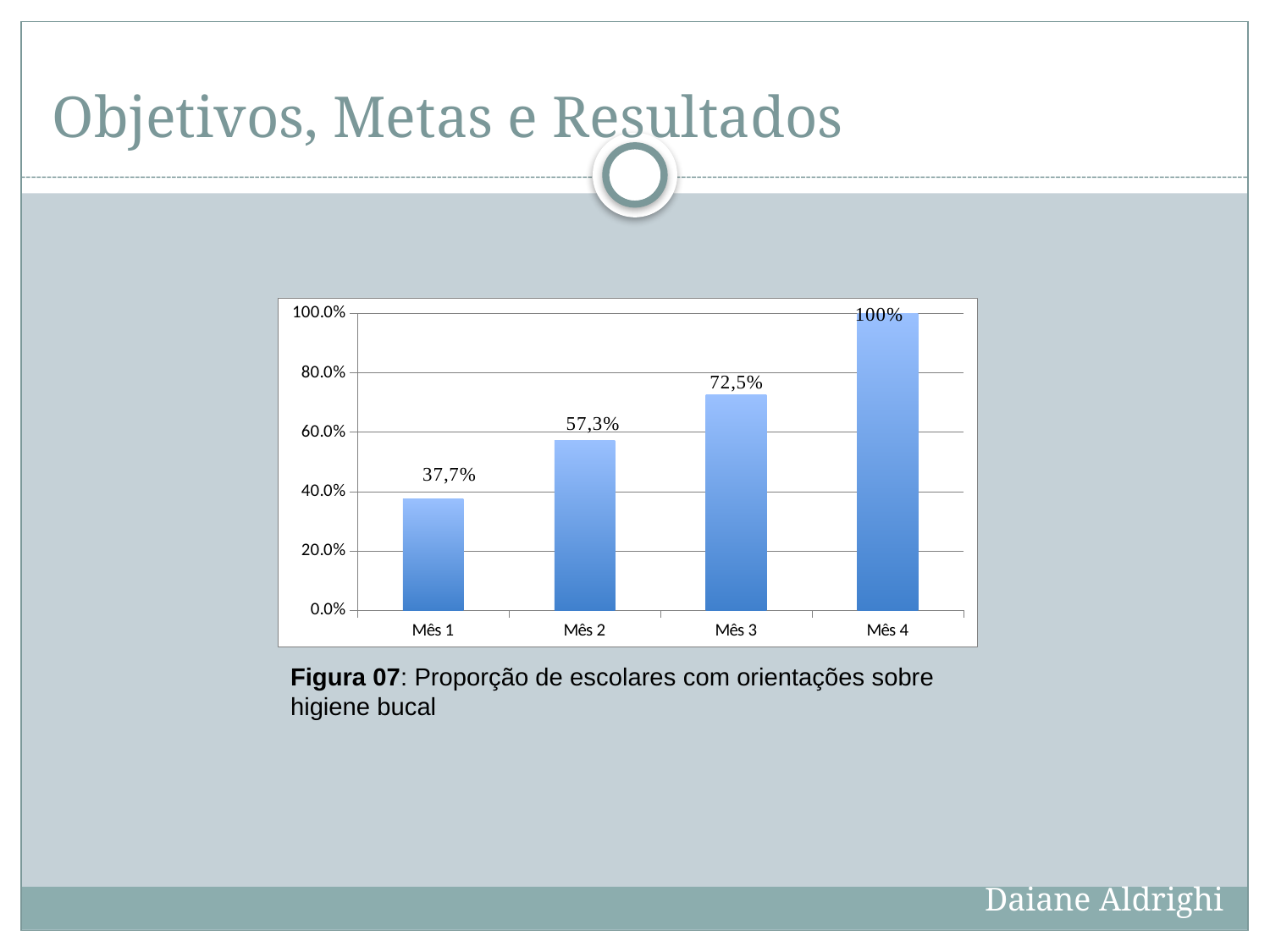
Do the values rise or fall from Mês 1 to Mês 4? rise How many months are shown on the x axis? 4 What is the value for Mês 4? 100% What is the value for Mês 3? 72,5% Which month has the lowest value? Mês 1 What kind of chart is shown on the slide? bar chart Which is larger, the value for Mês 2 or the value for Mês 3? Mês 3 Which month has the highest value? Mês 4 What is the value for Mês 1? 37,7% Is the value for Mês 1 greater or less than 40.0%? less What is the difference between the values for Mês 3 and Mês 2? 15,2% What is the value for Mês 2? 57,3%